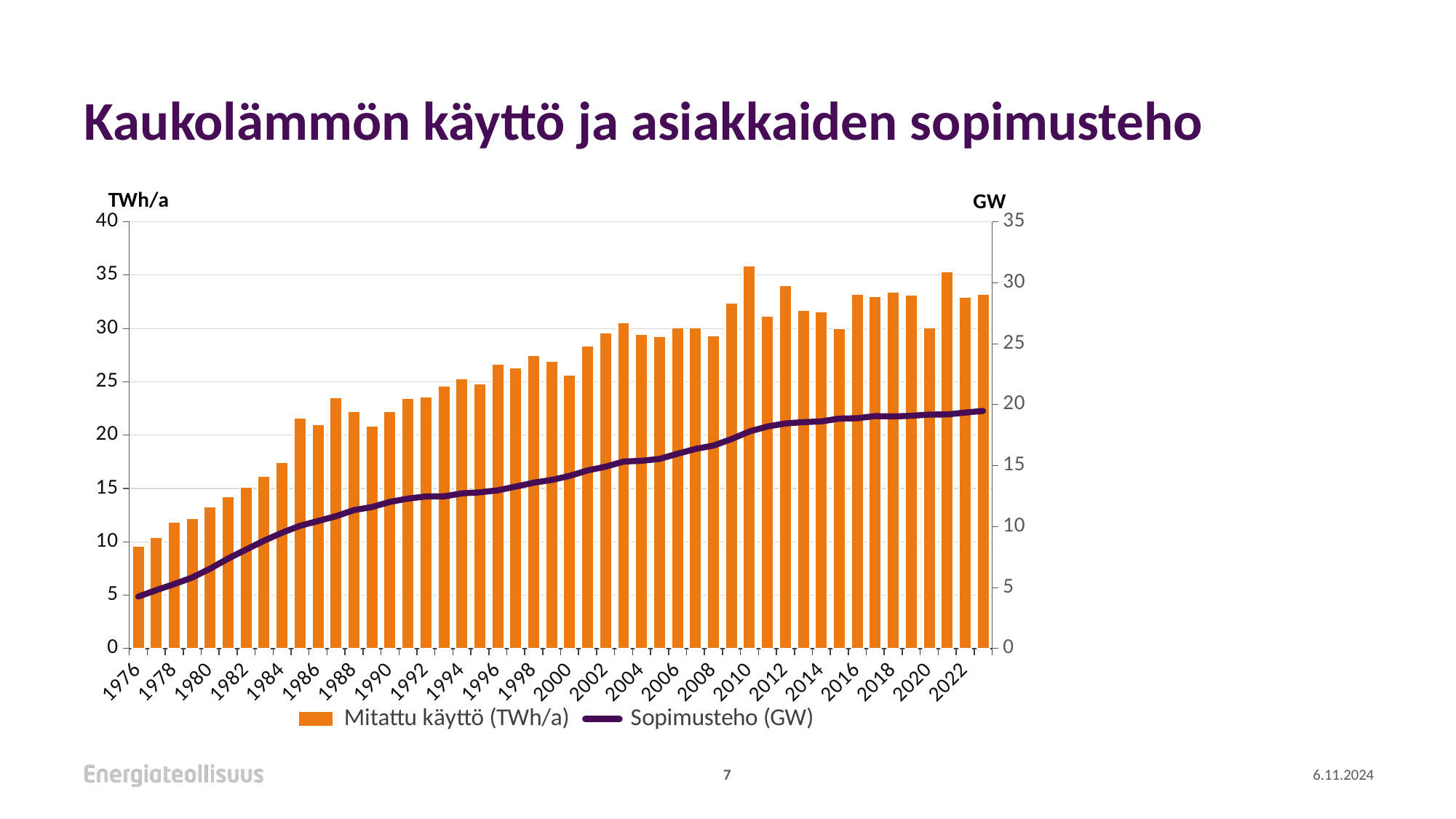
Which year has the larger Mitattu käyttö value, 1980 or 2000? 2000 What kind of chart is shown on the slide? A combined bar and line chart What is the title of the chart? Kaukolämmön käyttö ja asiakkaiden sopimusteho In which year is the Mitattu käyttö bar the highest? 2010 In which year is the Mitattu käyttö bar the lowest? 1976 Is the Mitattu käyttö value for 1976 greater or less than 15 TWh/a? less How many series does the legend list? 2 Which series is drawn as a line? Sopimusteho (GW) Is the Sopimusteho value for 2022 greater or less than 15 GW? greater Is the Mitattu käyttö value for 2010 greater or less than 30 TWh/a? greater Does the Sopimusteho line generally rise or fall from 1976 to 2023? rise